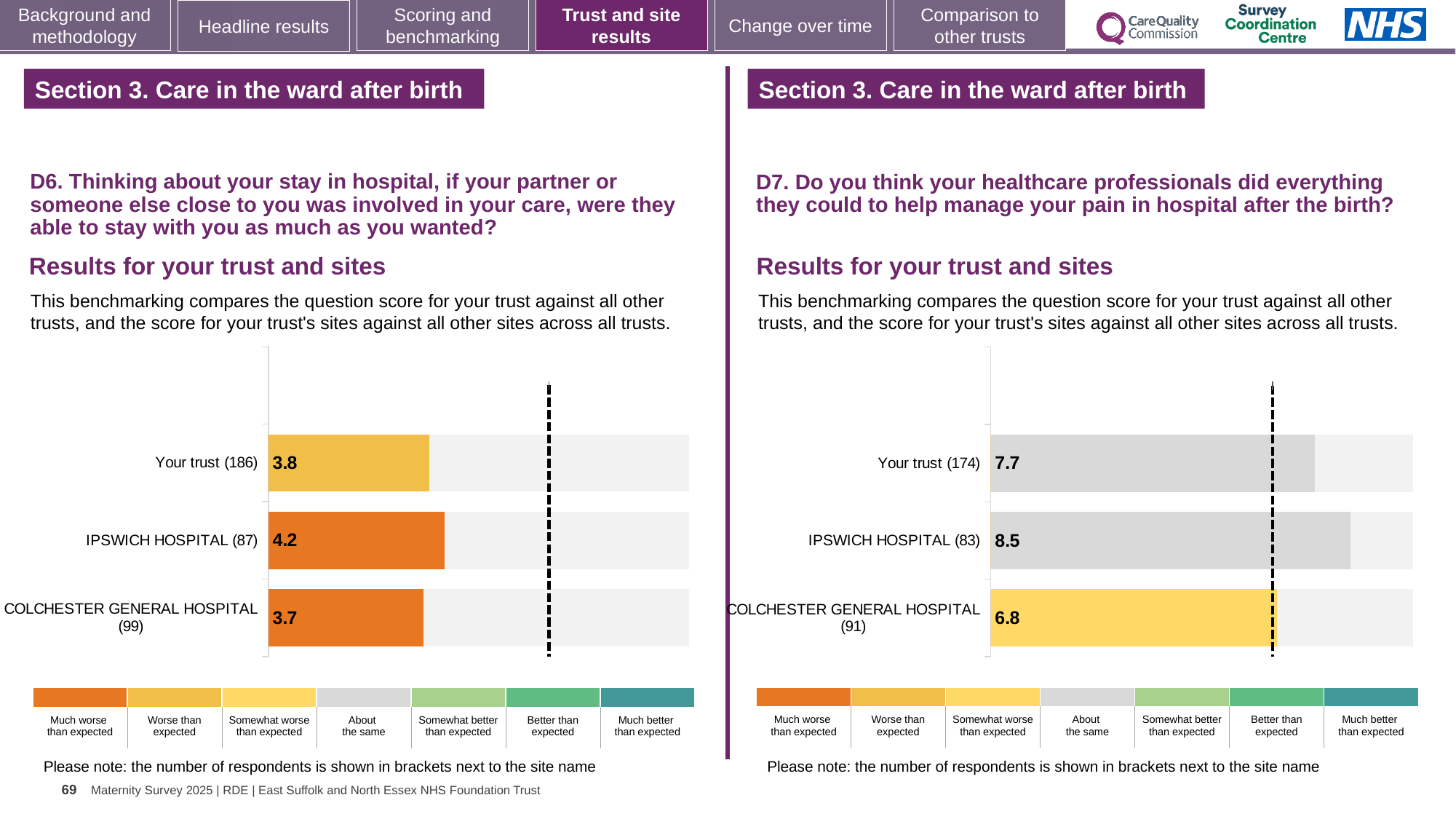
How many bars are plotted in the D7 chart on the right? 3 In the D7 chart on the right, which benchmark category does the colour of the COLCHESTER GENERAL HOSPITAL bar correspond to in the legend? Somewhat worse than expected In the D6 chart on the left, how many respondents are shown in brackets for Your trust? 186 In the D6 chart on the left, what is the difference between the scores for IPSWICH HOSPITAL and COLCHESTER GENERAL HOSPITAL? 0.5 In the D7 chart on the right, which has the larger score, Your trust or COLCHESTER GENERAL HOSPITAL? Your trust In the D7 chart on the right, what is the difference between the scores for IPSWICH HOSPITAL and Your trust? 0.8 In the D6 chart on the left, what is the score for IPSWICH HOSPITAL? 4.2 What kind of chart is used for the D6 results on the left? Bar chart In the D7 chart on the right, what is the score for COLCHESTER GENERAL HOSPITAL? 6.8 In the D6 chart on the left, which site or trust has the lowest score? COLCHESTER GENERAL HOSPITAL In the D7 chart on the right, which site or trust has the highest score? IPSWICH HOSPITAL In the D6 chart on the left, what is the score for Your trust? 3.8